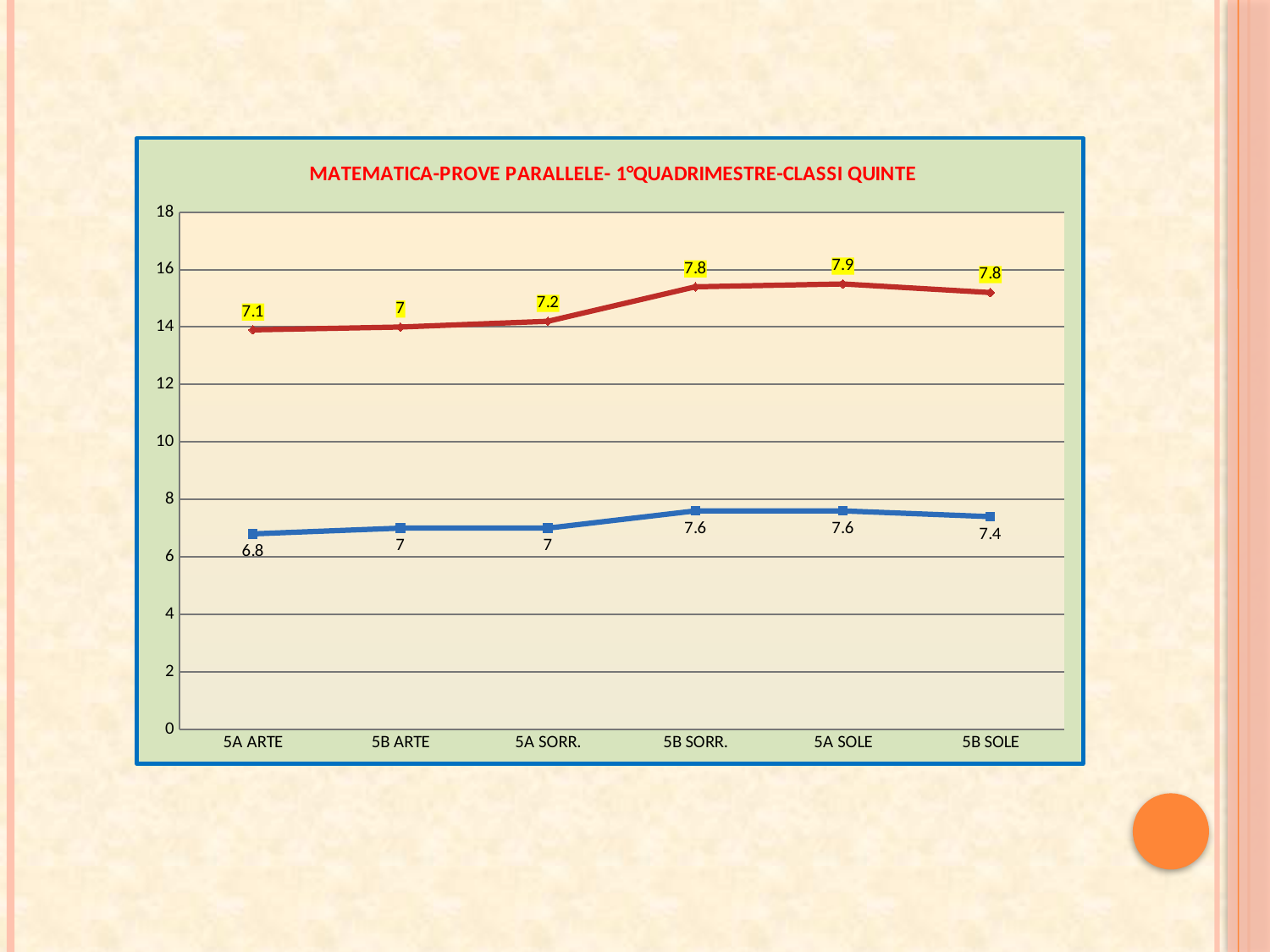
Which class has the lowest value labelled on the red line? 5B ARTE On the blue line, which is larger: the value for 5B SORR. or the value for 5B SOLE? 5B SORR. Which class has the lowest value on the blue line? 5A ARTE What is the value of the blue line for 5A ARTE? 6.8 Which class has the highest value labelled on the red line? 5A SOLE How many classes are shown along the x axis of the chart? 6 What is the difference between the red line's labelled values for 5A SOLE and 5A ARTE? 0.8 What is the title of the chart? MATEMATICA-PROVE PARALLELE- 1°QUADRIMESTRE-CLASSI QUINTE What is the value of the blue line for 5B SOLE? 7.4 What type of chart is shown on the slide? line chart Does the blue line rise or fall from 5A ARTE to 5B SORR.? rise What is the value labelled on the red line for 5A SOLE? 7.9